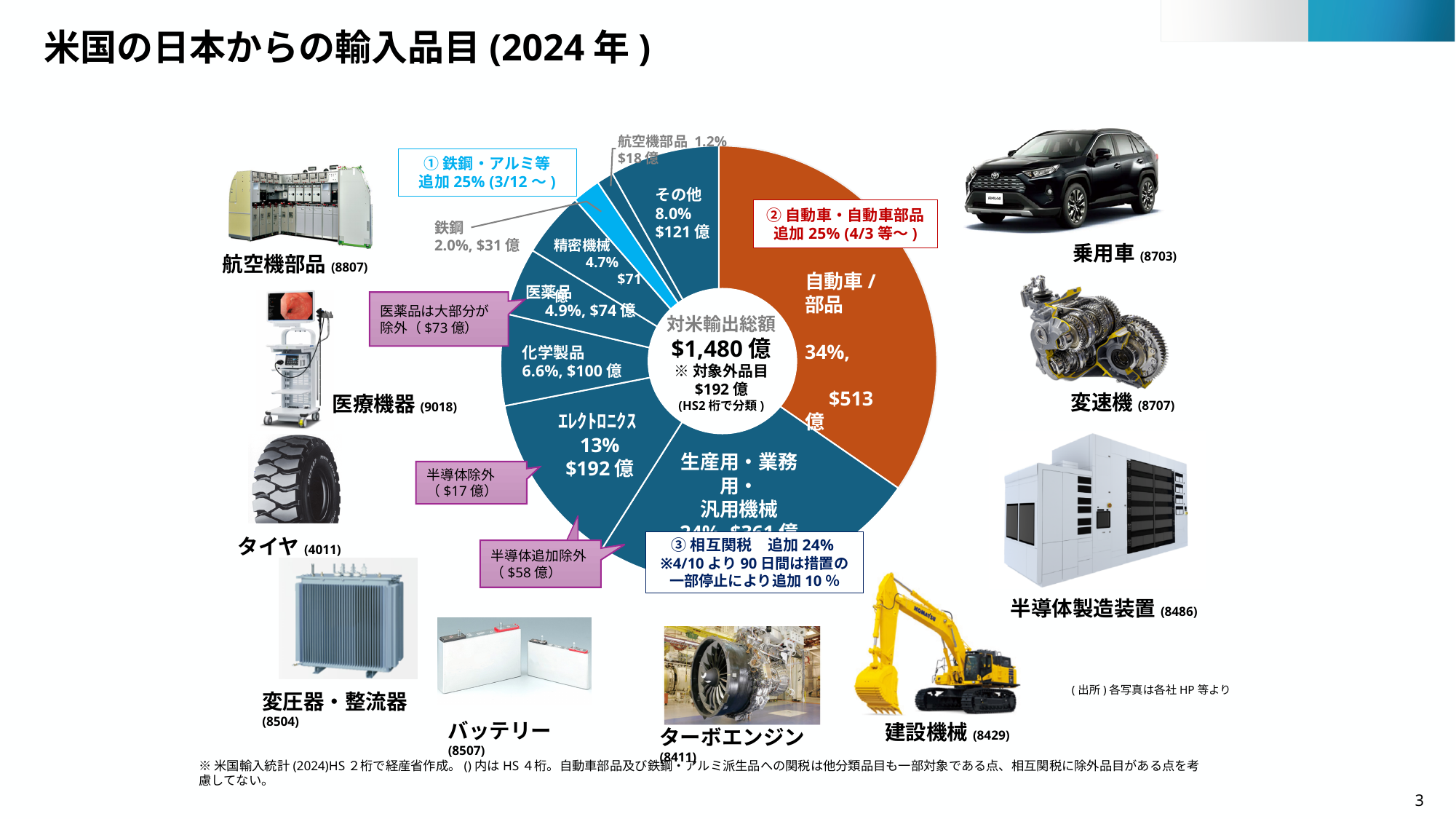
円グラフの中央に示されている対米輸出総額はいくらですか？ $1,480億 円グラフで最も割合が大きい品目はどれですか？ 自動車/部品 円グラフで「自動車/部品」と「エレクトロニクス」の金額の差はいくらですか？ $321億 円グラフで「自動車/部品」の金額はいくらですか？ $513億 円グラフで「鉄鋼」の金額はいくらですか？ $31億 円グラフで「自動車/部品」の割合は何%ですか？ 34% 円グラフで最も割合が小さい品目はどれですか？ 航空機部品 円グラフで「化学製品」の割合は何%ですか？ 6.6% 円グラフで「エレクトロニクス」の金額はいくらですか？ $192億 このスライドのグラフはどの種類のグラフですか？ 円グラフ 円グラフには品目がいくつ示されていますか？ 9 円グラフで「医薬品」と「精密機械」では、どちらの割合が大きいですか？ 医薬品